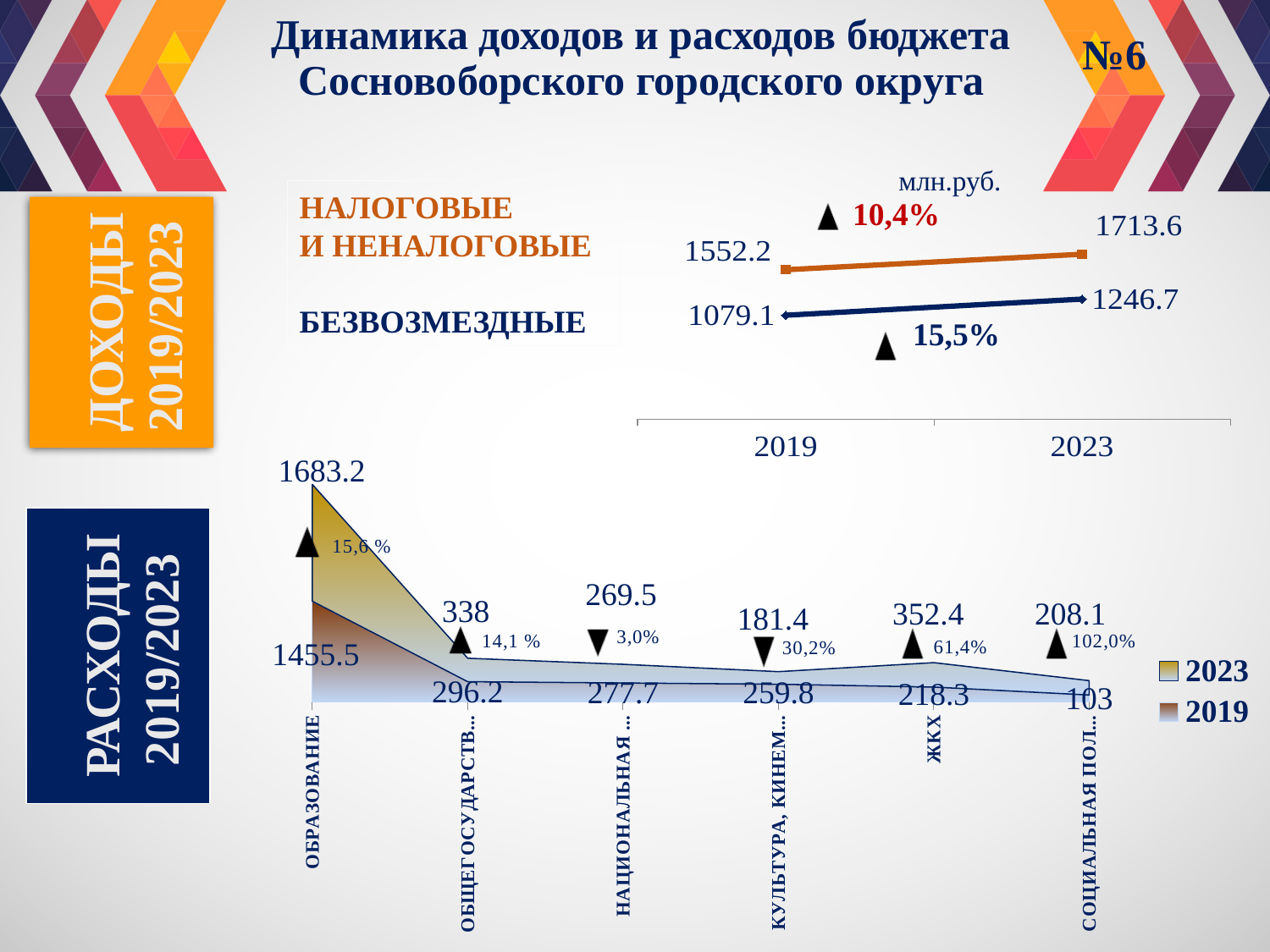
What kind of chart is the top chart (ДОХОДЫ 2019/2023)? line chart How many series are plotted in the top chart (ДОХОДЫ 2019/2023)? 2 In the top chart (ДОХОДЫ 2019/2023), by how much did НАЛОГОВЫЕ И НЕНАЛОГОВЫЕ increase from 2019 to 2023? 161.4 In the bottom chart (РАСХОДЫ 2019/2023), what is the 2023 value for ОБРАЗОВАНИЕ? 1683.2 In the top chart (ДОХОДЫ 2019/2023), does the БЕЗВОЗМЕЗДНЫЕ line rise or fall from 2019 to 2023? rises How many expenditure categories are shown on the x axis of the bottom chart (РАСХОДЫ 2019/2023)? 6 In the bottom chart (РАСХОДЫ 2019/2023), what is the 2019 value for ЖКХ? 218.3 In the top chart (ДОХОДЫ 2019/2023), what is the value for НАЛОГОВЫЕ И НЕНАЛОГОВЫЕ in 2023? 1713.6 In the top chart (ДОХОДЫ 2019/2023), what is the value for БЕЗВОЗМЕЗДНЫЕ in 2019? 1079.1 In the bottom chart (РАСХОДЫ 2019/2023), what is the difference between the 2023 and 2019 values for ЖКХ? 134.1 In the bottom chart (РАСХОДЫ 2019/2023), which category has the highest 2023 value? ОБРАЗОВАНИЕ What are the two legend entries of the bottom chart (РАСХОДЫ 2019/2023)? 2023 and 2019